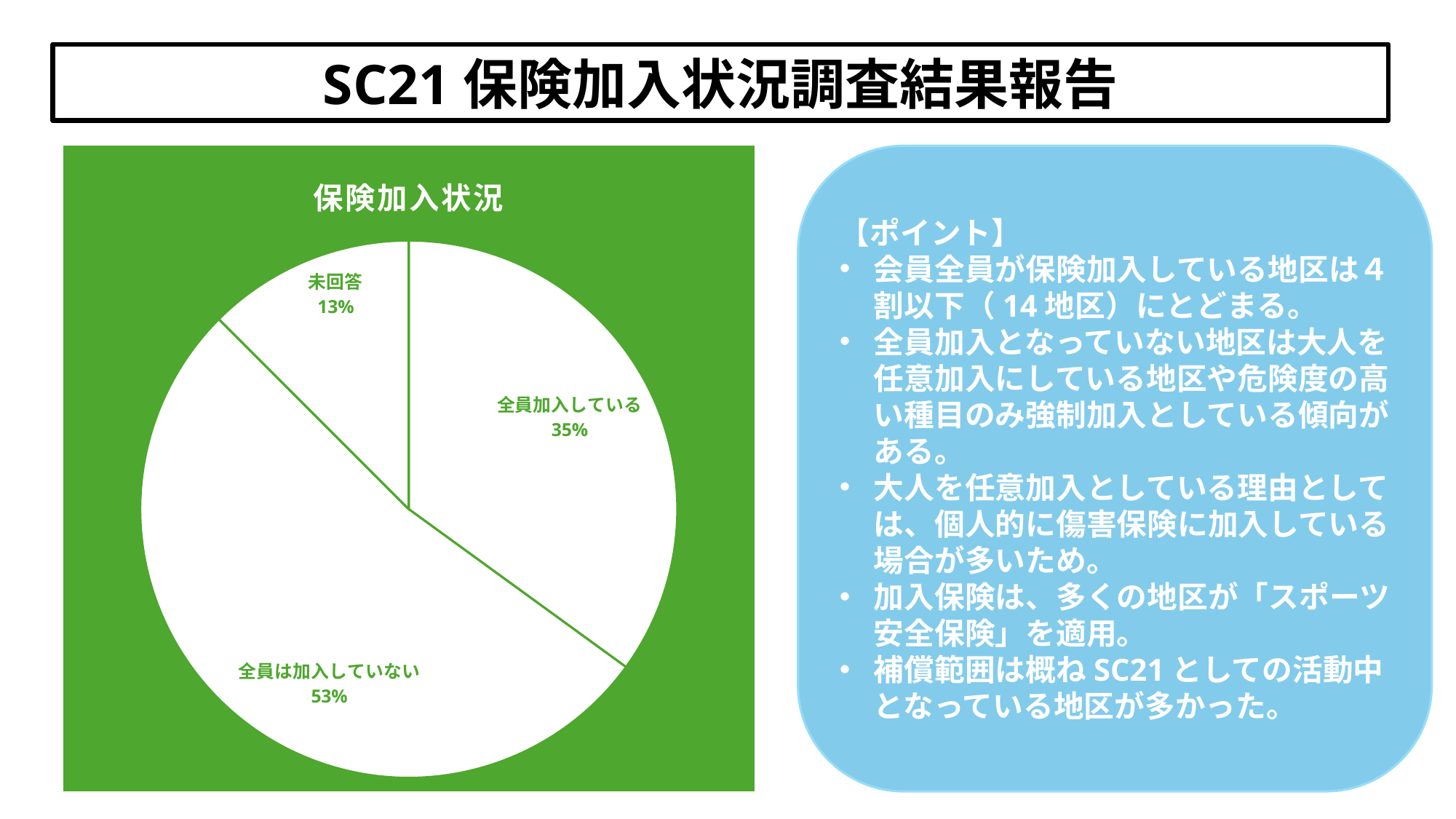
What share of the pie is 全員は加入していない? 53% What is the difference between the shares of 全員加入している and 未回答? 22% What is the title of the chart? 保険加入状況 Which is larger, the share of 全員加入している or the share of 未回答? 全員加入している How many slices does the pie chart have? 3 Which category has the largest slice of the pie? 全員は加入していない Which category has the smallest slice of the pie? 未回答 What share of the pie is 全員加入している? 35% Is the share of 全員は加入していない greater or less than 50%? greater What is the difference between the shares of 全員は加入していない and 全員加入している? 18% What kind of chart is shown on the slide? pie chart What share of the pie is 未回答? 13%